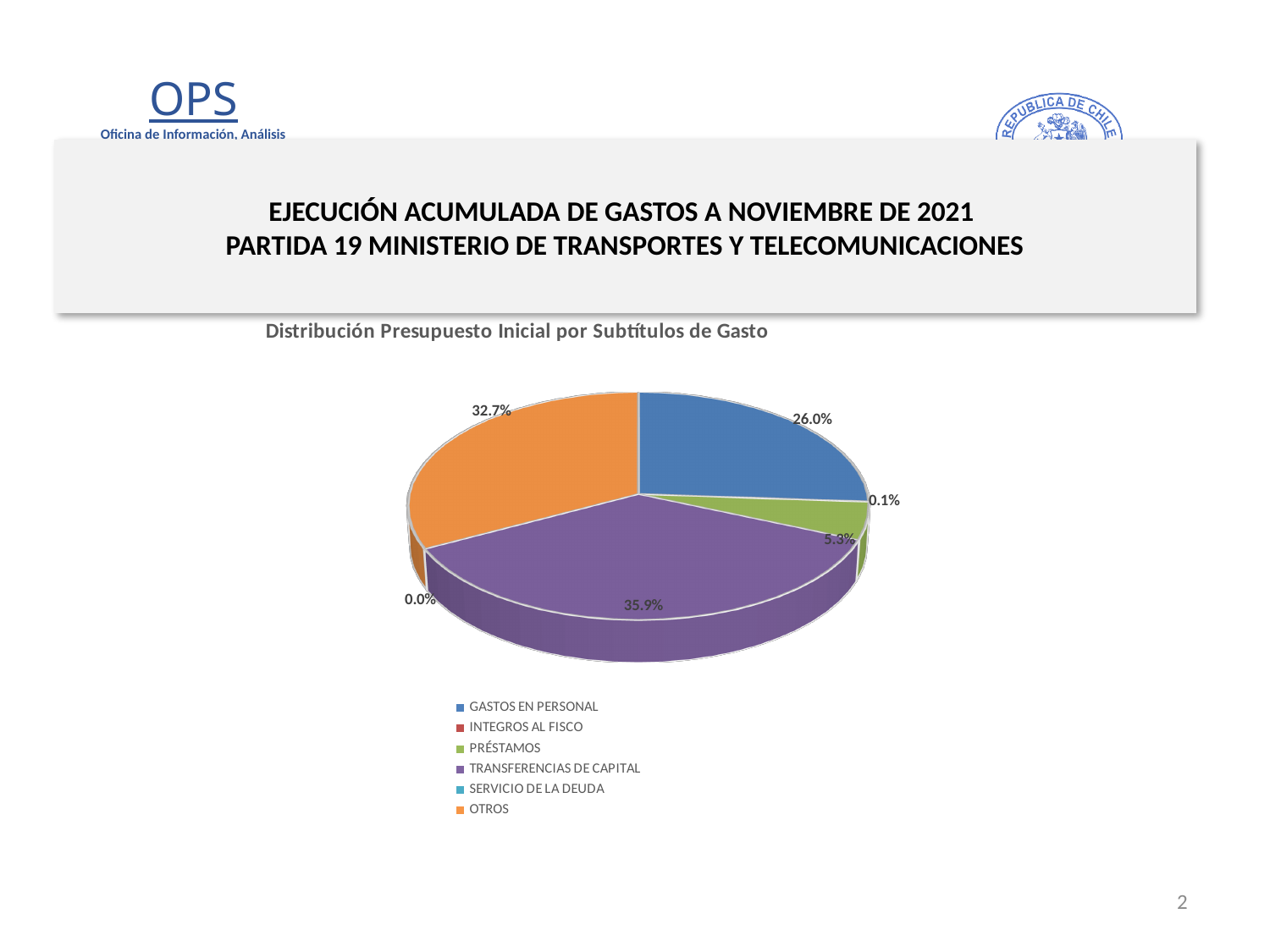
What colour is the OTROS slice? Orange What share of the pie does GASTOS EN PERSONAL represent? 26.0% What percentage is shown for TRANSFERENCIAS DE CAPITAL? 35.9% What percentage is shown for OTROS? 32.7% What kind of chart is shown on the slide? Pie chart Which category has the largest slice of the pie? TRANSFERENCIAS DE CAPITAL What is the difference in percentage points between TRANSFERENCIAS DE CAPITAL and OTROS? 3.2 What percentage is shown for PRÉSTAMOS? 5.3% What is the title of the chart? Distribución Presupuesto Inicial por Subtítulos de Gasto Which is larger, the share for GASTOS EN PERSONAL or the share for PRÉSTAMOS? GASTOS EN PERSONAL How many categories does the legend list? 6 Which category has the smallest labelled share of the pie? SERVICIO DE LA DEUDA